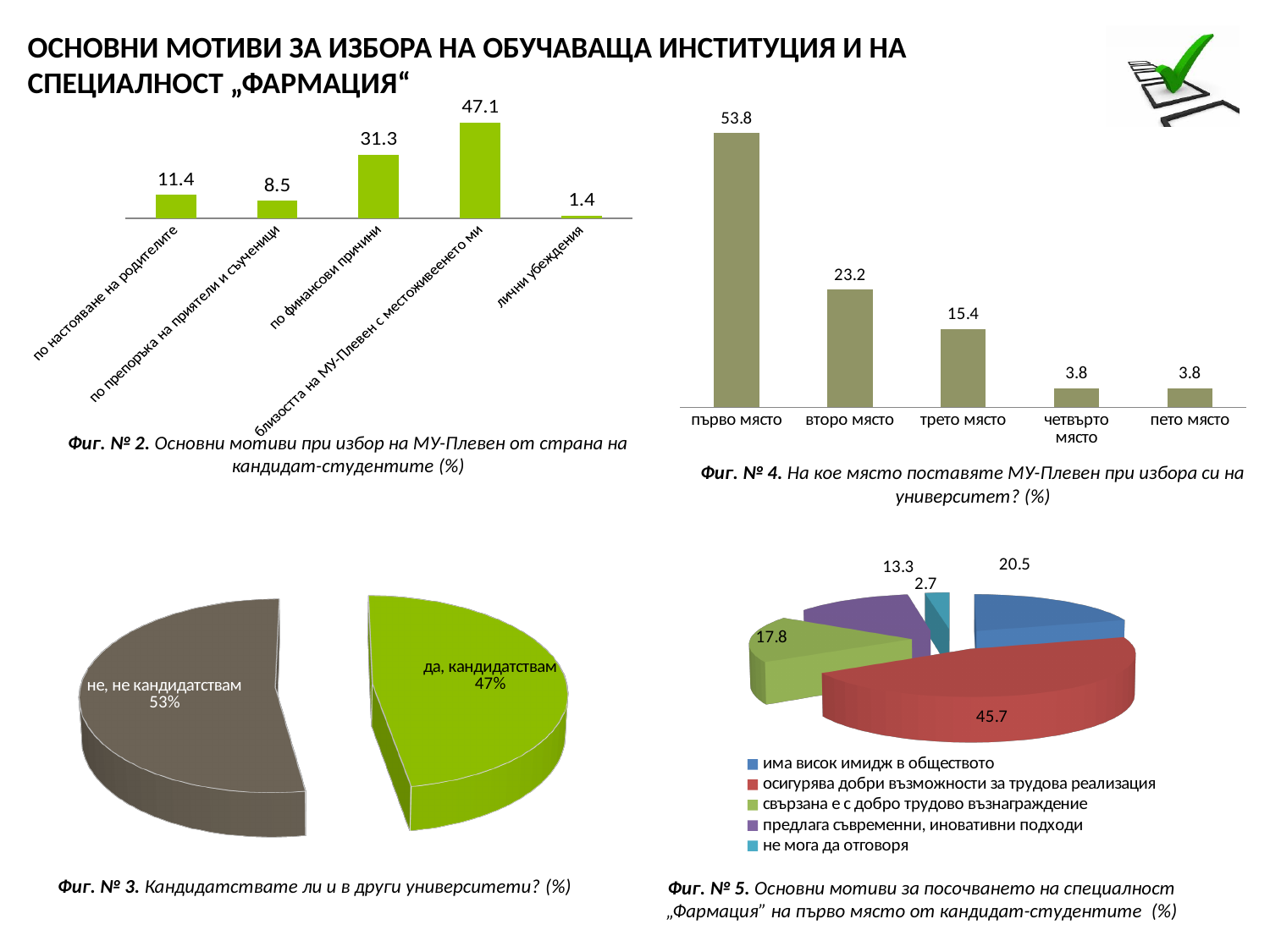
In the chart Фиг. № 2, which category has the lowest value? лични убеждения In the chart Фиг. № 2, what is the difference between the values for "по настояване на родителите" and "по препоръка на приятели и съученици"? 2.9 In the chart Фиг. № 3, what share of the pie is "да, кандидатстваме"? 47% In the chart Фиг. № 4, how many categories are shown on the x axis? 5 How many entries does the legend of the chart Фиг. № 5 list? 5 What kind of chart is Фиг. № 3? pie chart In the chart Фиг. № 5, what is the value for "осигурява добри възможности за трудова реализация"? 45.7 In the chart Фиг. № 2, what is the value for "по финансови причини"? 31.3 In the chart Фиг. № 2, which category has the highest value? близостта на МУ-Плевен с местоживеенето ми In the chart Фиг. № 4, what is the difference between the values for "първо място" and "трето място"? 38.4 In the chart Фиг. № 4, do the values rise or fall from "първо място" to "пето място"? fall In the chart Фиг. № 4, what is the value for "второ място"? 23.2